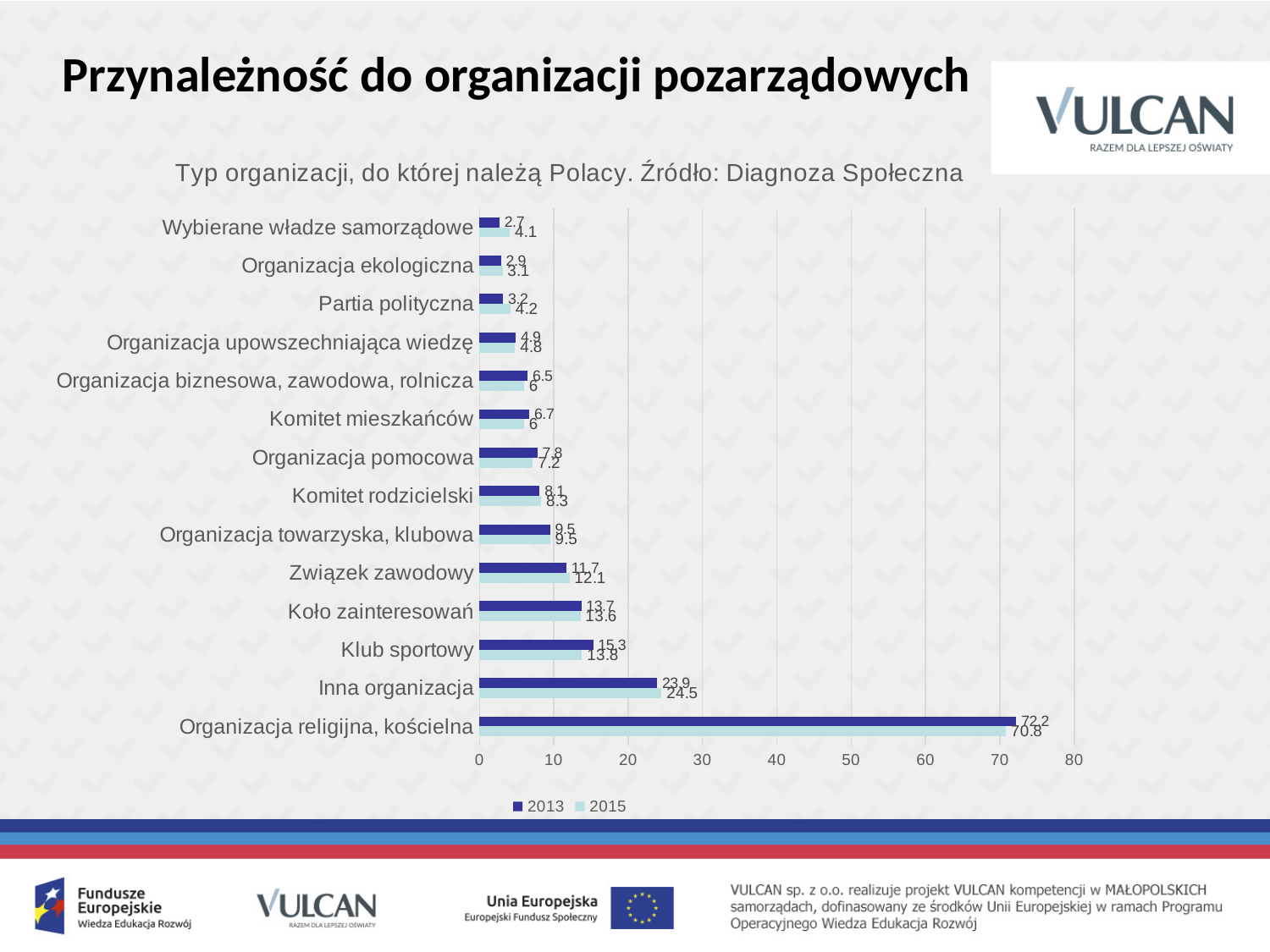
How many series does the legend list? 2 Which category has the highest 2015 value? Organizacja religijna, kościelna How many categories are shown on the chart? 14 Which is larger for Klub sportowy: the 2013 value or the 2015 value? 2013 What is the difference between the 2013 and 2015 values for Organizacja religijna, kościelna? 1.4 What is the 2013 value for Klub sportowy? 15.3 What is the 2015 value for Wybierane władze samorządowe? 4.1 What is the 2013 value for Organizacja religijna, kościelna? 72.2 Is the 2013 value for Inna organizacja greater or less than 20? greater What kind of chart is shown on the slide? Bar chart Which category has the lowest 2013 value? Wybierane władze samorządowe What is the 2015 value for Inna organizacja? 24.5